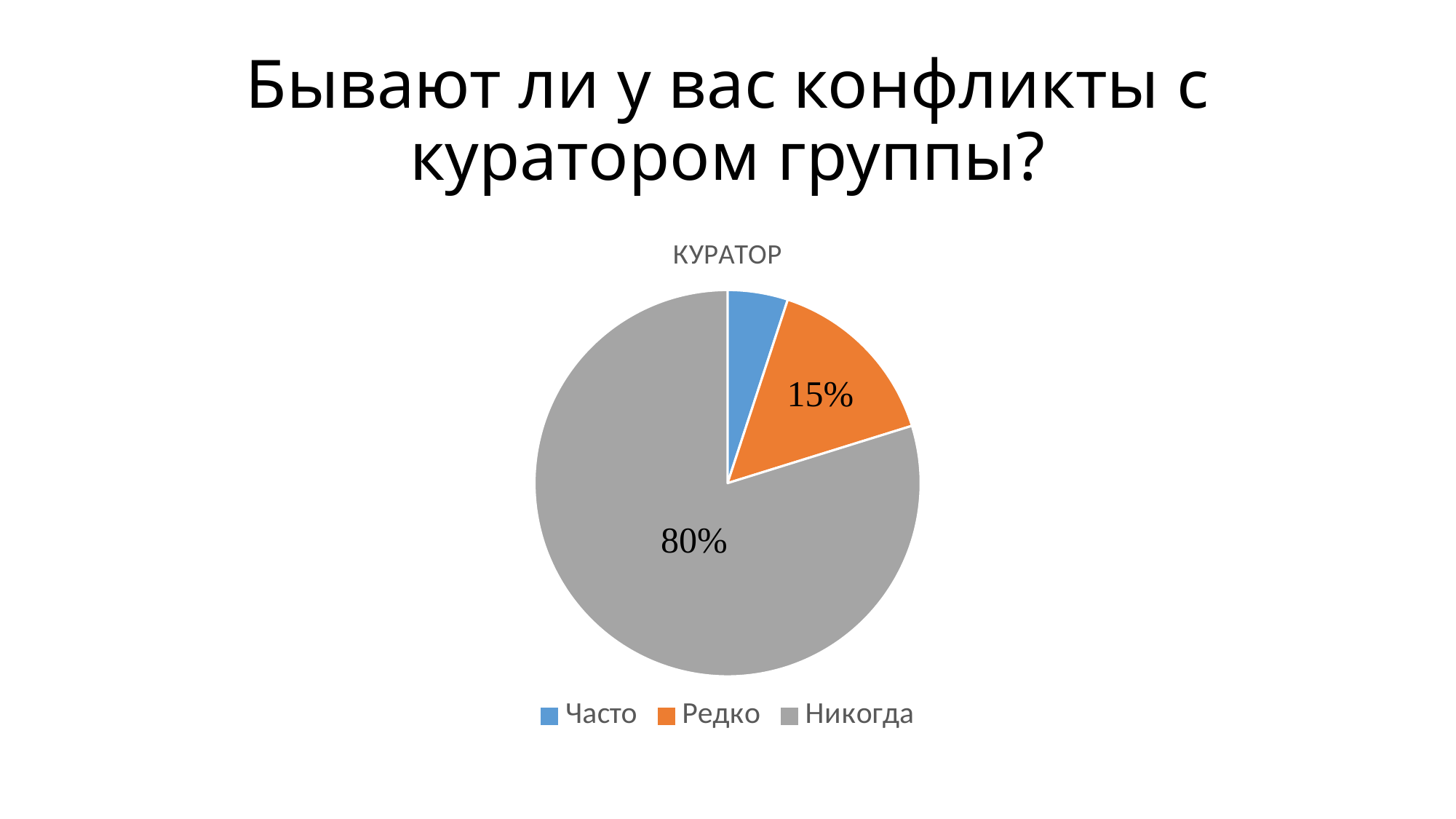
What is the difference between the shares for Никогда and Редко? 65% What kind of chart is shown on the slide? Pie chart Which category has the largest slice of the pie? Никогда Which slice is larger, Редко or Часто? Редко What colour is the Редко slice? Orange How many categories are shown in the pie chart? 3 What share of the pie does Никогда represent? 80% Which category has the smallest slice of the pie? Часто What share of the pie does Редко represent? 15% Which slice is larger, Никогда or Редко? Никогда What is the title of the chart? КУРАТОР